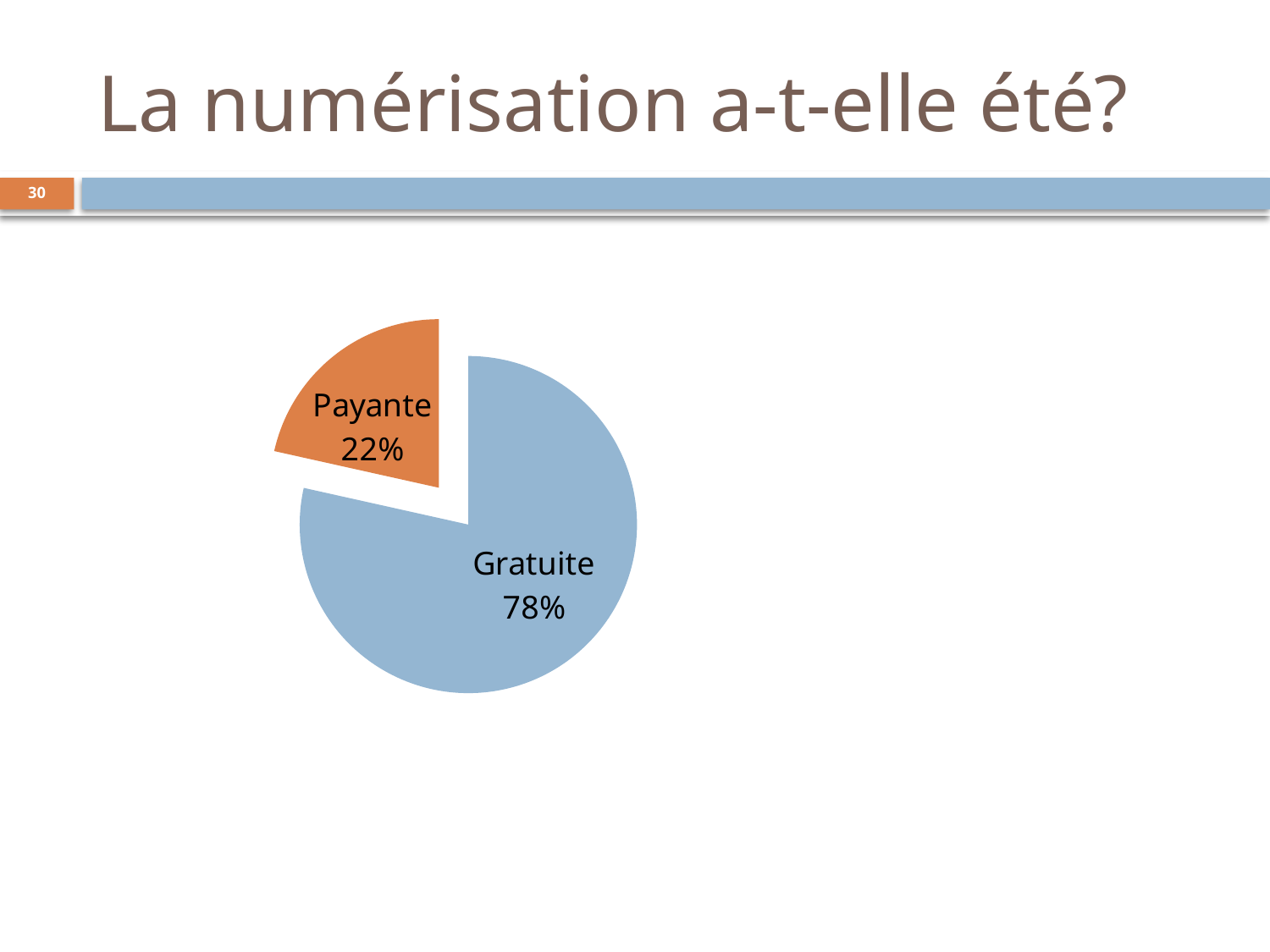
Which slice of the pie is the largest? Gratuite How many slices does the pie chart have? 2 What is the difference in percentage points between the Gratuite and Payante slices? 56 What kind of chart is shown on the slide? pie chart What share of the pie does Payante represent? 22% Which slice of the pie is the smallest? Payante Which is larger, the Gratuite slice or the Payante slice? Gratuite What is the title of the slide containing the pie chart? La numérisation a-t-elle été? What share of the pie does Gratuite represent? 78% What colour is the Payante slice? orange